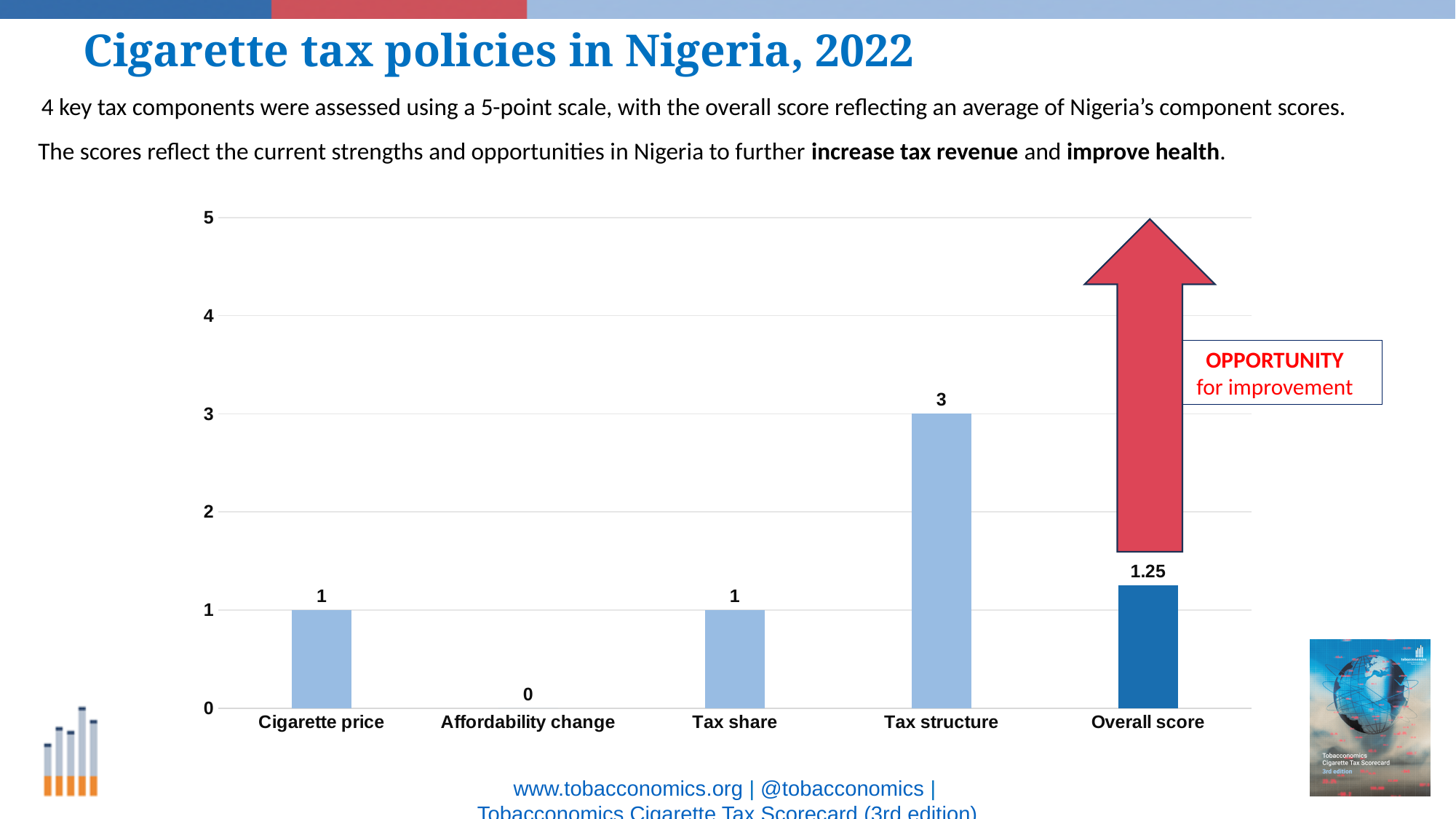
Which is larger, the value for Overall score or the value for Cigarette price? Overall score What is the difference between the values for Tax structure and Tax share? 2 Is the value for Tax structure greater or less than 2? greater Which category has the lowest value? Affordability change What is the highest value shown on the y axis? 5 What is the value for Tax structure? 3 What is the value for Cigarette price? 1 What is the value for Overall score? 1.25 What is the value for Affordability change? 0 How many categories are shown on the x axis? 5 Which category has the highest value? Tax structure What kind of chart is shown on the slide? bar chart